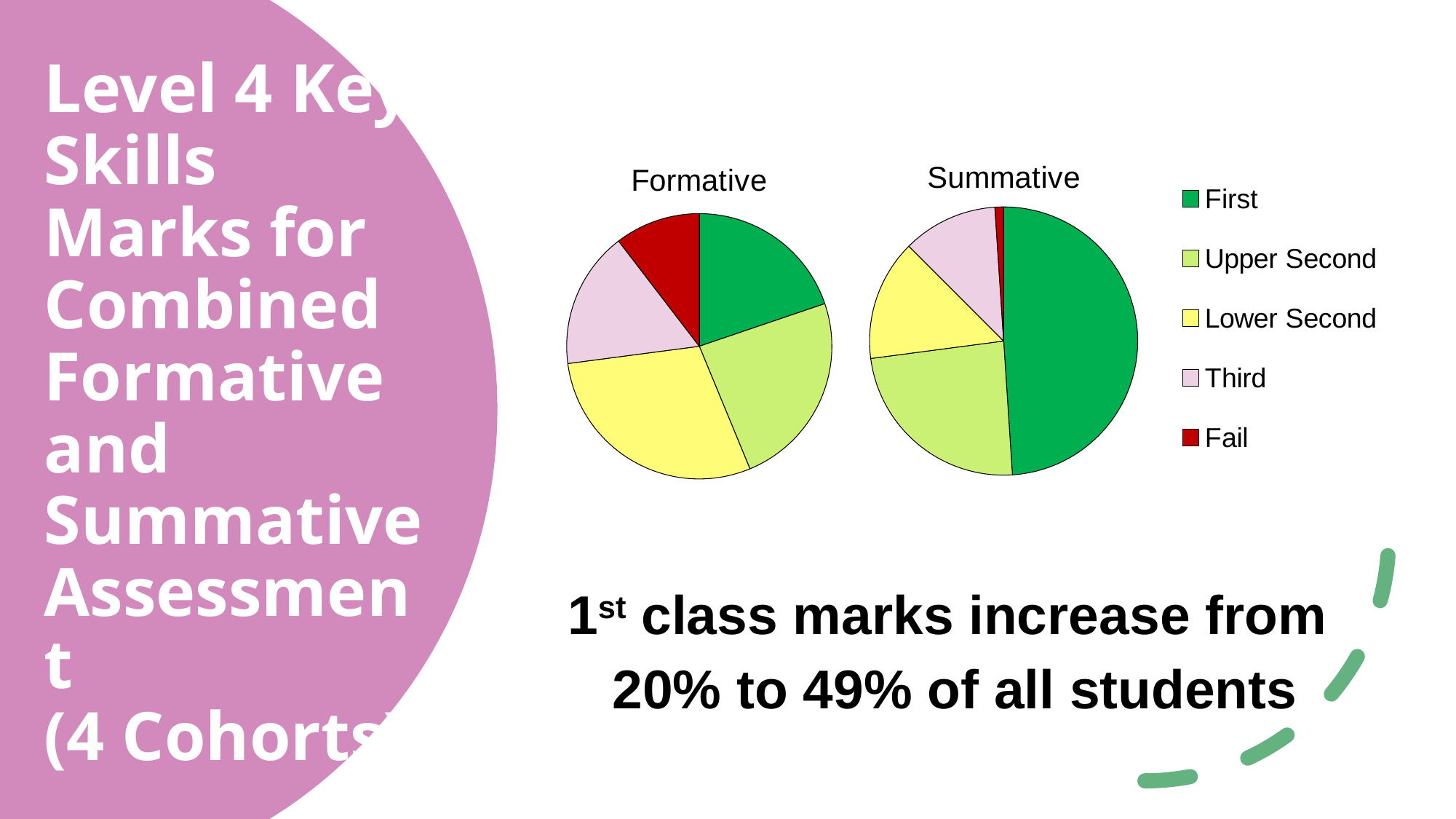
According to the slide, what share of all students received 1st class marks in the Summative assessment? 49% How many categories does the legend list? 5 In the Formative pie chart, which category has the largest slice? Lower Second In the Summative pie chart, which slice is larger: Third or Fail? Third How many charts are shown on the slide? 2 In the Summative pie chart, which category has the smallest slice? Fail Is the First slice larger in the Formative pie chart or the Summative pie chart? Summative Which colour represents the Fail category in the legend? red In the Summative pie chart, which category has the largest slice? First What kind of chart is used for the Formative and Summative data? pie chart According to the slide, what share of all students received 1st class marks in the Formative assessment? 20% In the Formative pie chart, which category has the smallest slice? Fail